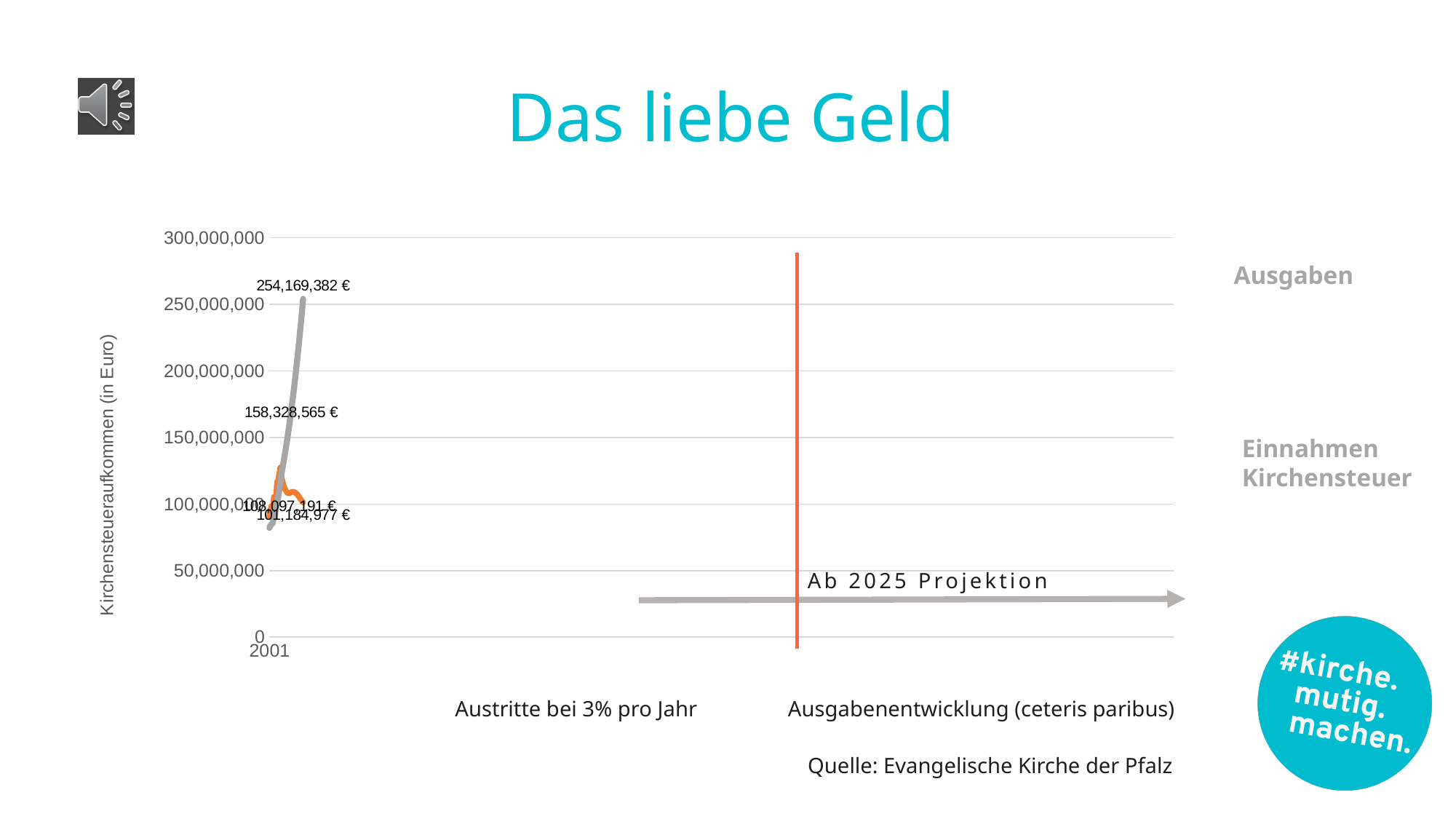
What kind of chart is shown on the slide? line chart What is the lowest value printed as a data label on the chart? 101,184,977 € What is the title of the slide containing the chart? Das liebe Geld What is the difference between the data labels 108,097,191 € and 101,184,977 €? 6,912,214 € What is the highest tick value shown on the vertical axis? 300,000,000 How many data labels are printed on the chart? 4 What is the first year shown on the horizontal axis? 2001 What is the difference between the data labels 254,169,382 € and 158,328,565 €? 95,840,817 € What is the label on the vertical axis of the chart? Kirchensteueraufkommen (in Euro) What is the highest value printed as a data label on the chart? 254,169,382 € Which is larger, the data label 158,328,565 € or the data label 108,097,191 €? 158,328,565 € Is the highest point of the grey line greater or less than 250,000,000? greater